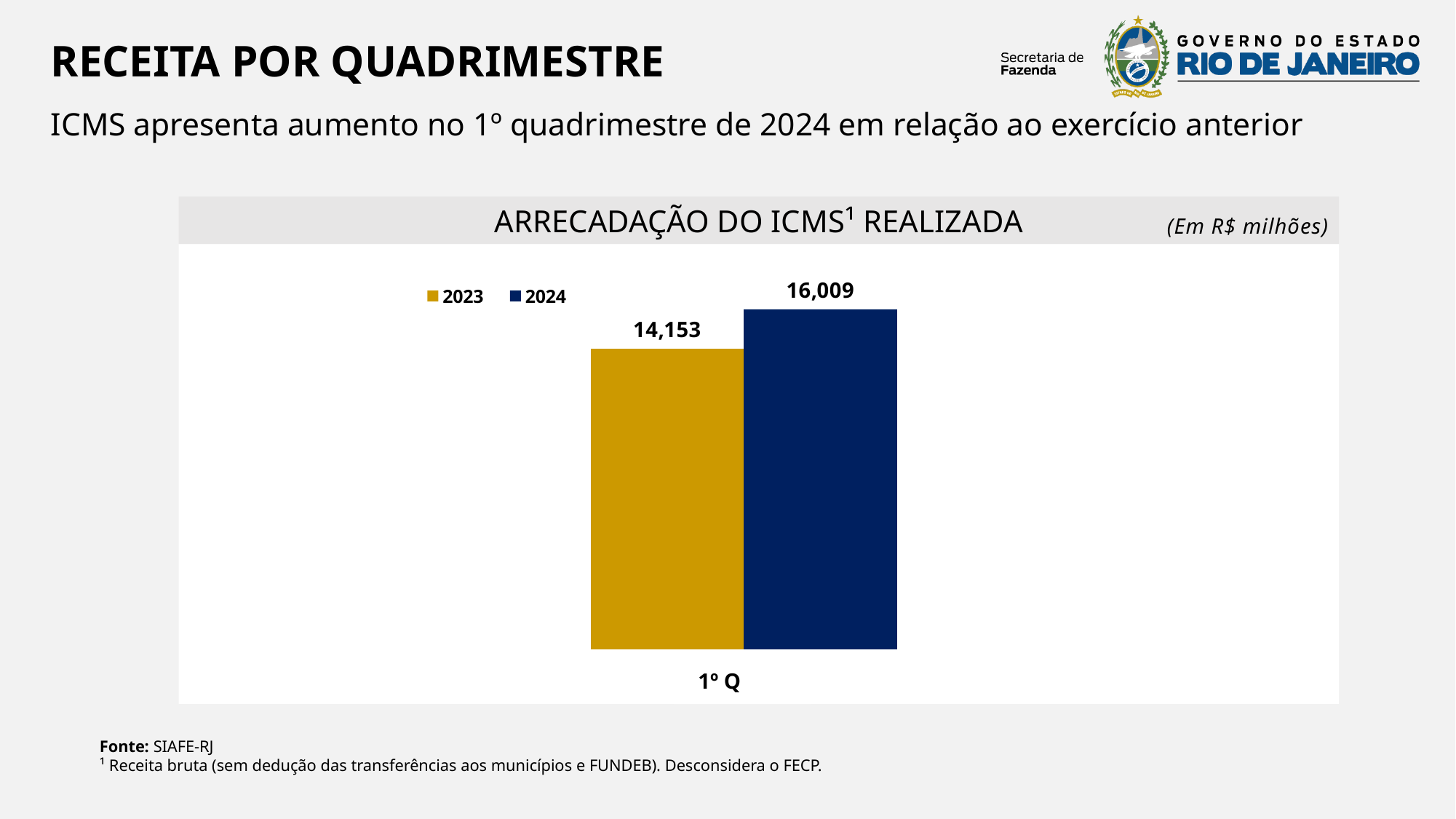
Which series is shown in dark blue? 2024 What is the value for 2023 in the 1º Q category? 14,153 What kind of chart is shown on the slide? Bar chart Which series has the lowest value in the chart? 2023 How many series does the legend list? 2 Which series has the higher value for 1º Q, 2023 or 2024? 2024 What unit is stated for the chart values? Em R$ milhões What is the difference between the 2024 and 2023 values for 1º Q? 1,856 What is the value for 2024 in the 1º Q category? 16,009 What is the title of the chart? ARRECADAÇÃO DO ICMS¹ REALIZADA How many categories are shown on the x axis? 1